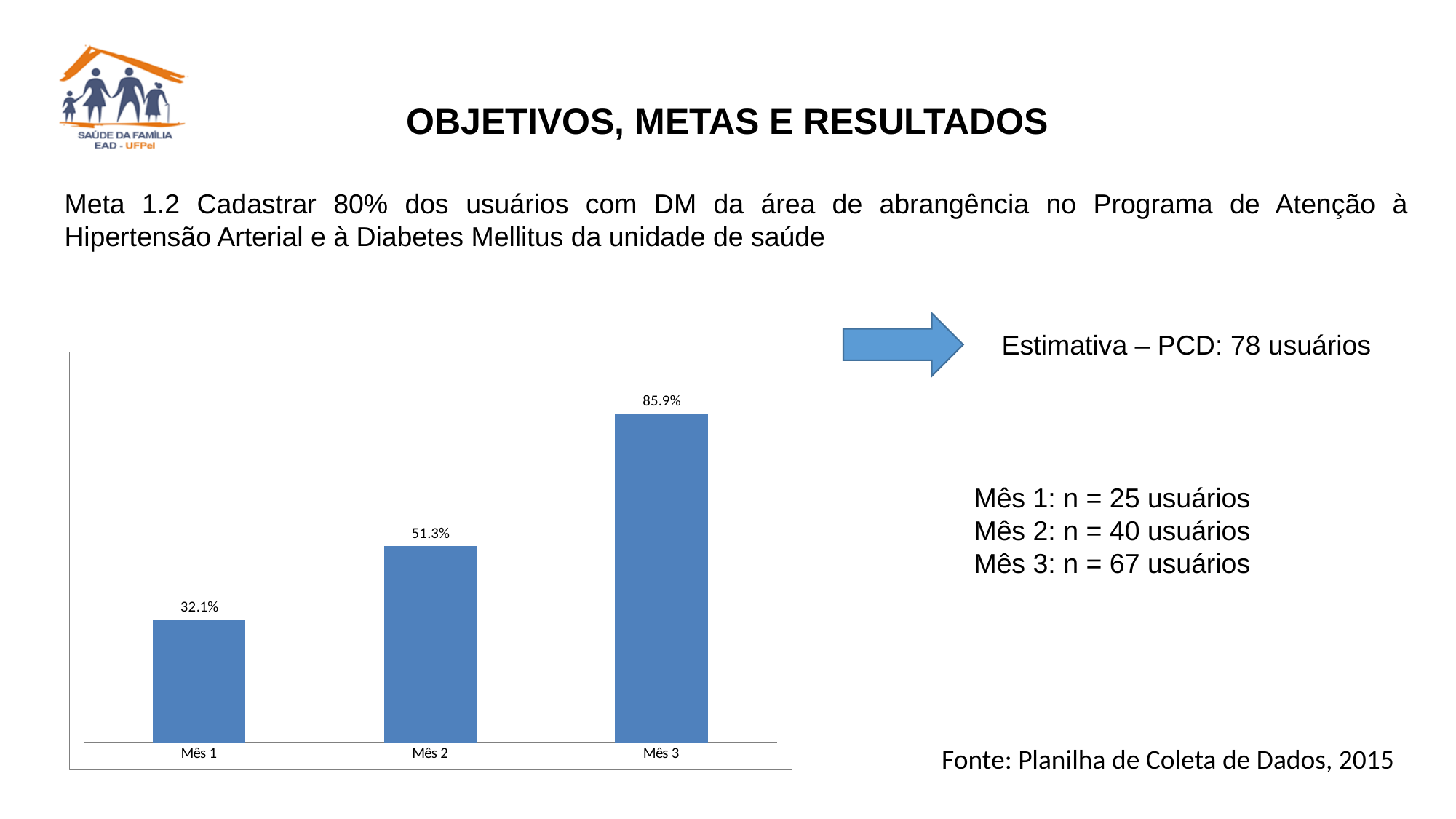
Do the values rise or fall from Mês 1 to Mês 3? Rise What is the value for Mês 1? 32.1% Which is larger, the value for Mês 2 or the value for Mês 3? Mês 3 What colour are the bars in the chart? Blue What is the value for Mês 2? 51.3% Which month has the highest value? Mês 3 How many categories are shown on the x axis of the chart? 3 Which month has the lowest value? Mês 1 What is the difference between the values for Mês 3 and Mês 1? 53.8% What is the value for Mês 3? 85.9% What is the difference between the values for Mês 2 and Mês 1? 19.2% What kind of chart is shown on the slide? Bar chart